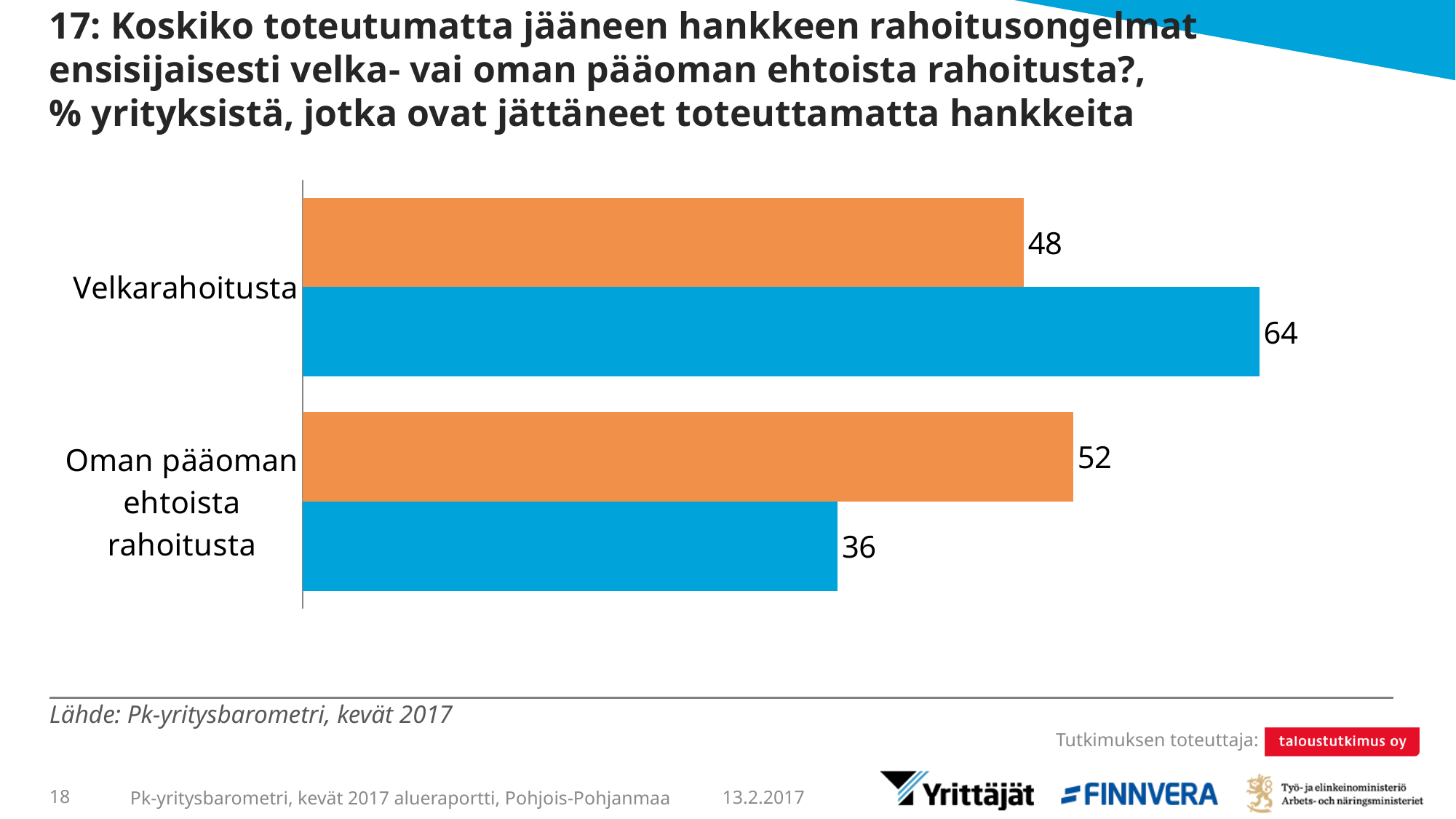
What is the value of the blue bar for Oman pääoman ehtoista rahoitusta? 36 For Oman pääoman ehtoista rahoitusta, is the orange bar or the blue bar larger? The orange bar What is the value of the blue bar for Velkarahoitusta? 64 What is the value of the orange bar for Velkarahoitusta? 48 What is the difference between the blue and orange bars for Velkarahoitusta? 16 What is the value of the orange bar for Oman pääoman ehtoista rahoitusta? 52 Which bar has the highest value in the chart? The blue bar for Velkarahoitusta (64) How many categories are shown on the chart? 2 What kind of chart is shown on the slide? Bar chart Which bar has the lowest value in the chart? The blue bar for Oman pääoman ehtoista rahoitusta (36) What is the difference between the orange and blue bars for Oman pääoman ehtoista rahoitusta? 16 What source is cited below the chart? Pk-yritysbarometri, kevät 2017